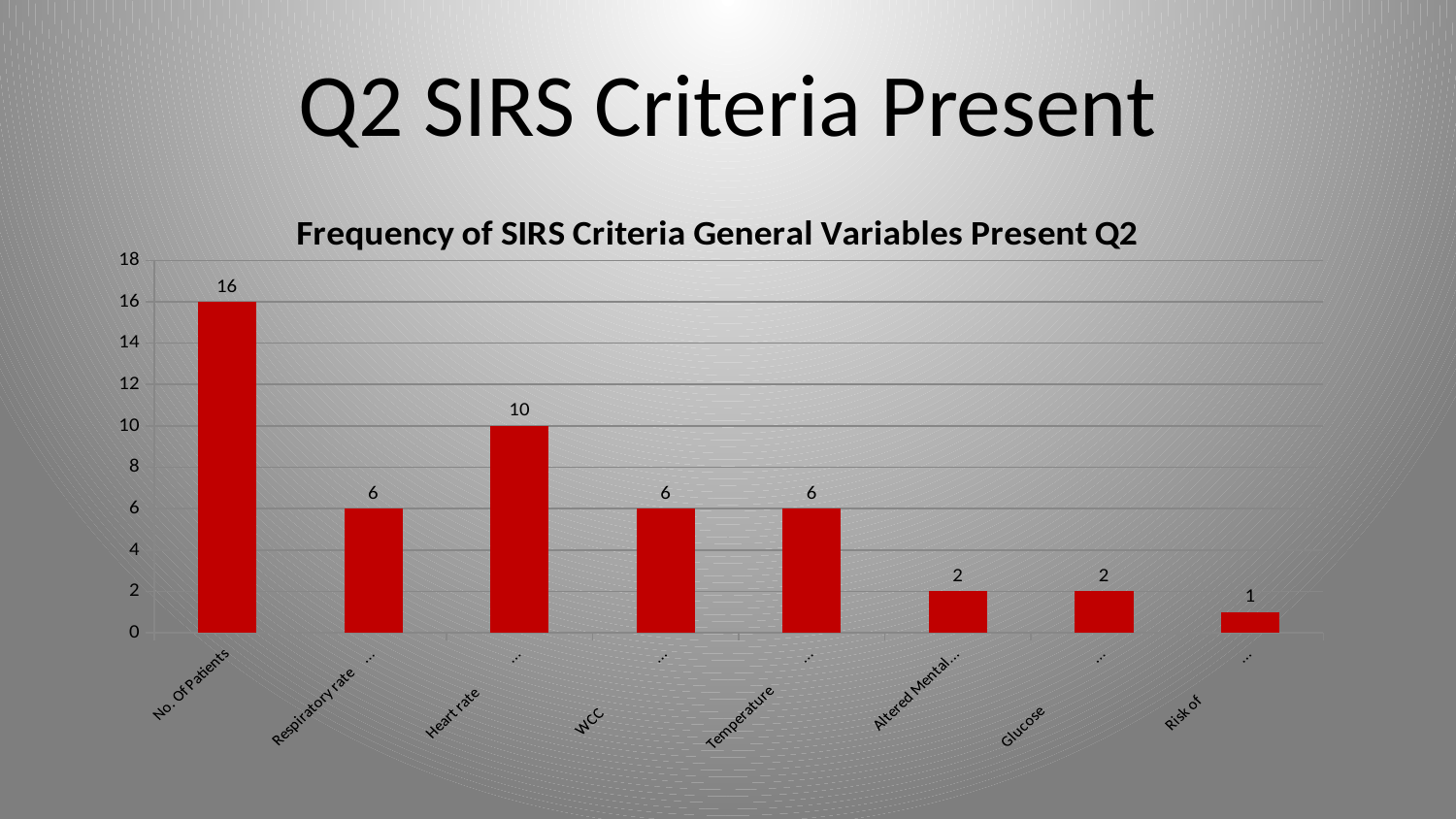
What kind of chart is shown on the slide? bar chart What is the difference between the values for No. Of Patients and Heart rate? 6 What is the value for Heart rate? 10 Which category has the highest value? No. Of Patients What is the value for No. Of Patients? 16 What is the value for Glucose? 2 What is the title of the chart? Frequency of SIRS Criteria General Variables Present Q2 How many categories are shown on the x axis? 8 Which category has the lowest value? Risk of Which is larger, the value for Heart rate or the value for WCC? Heart rate What is the value for Temperature? 6 Is the value for Respiratory rate greater or less than 8? less